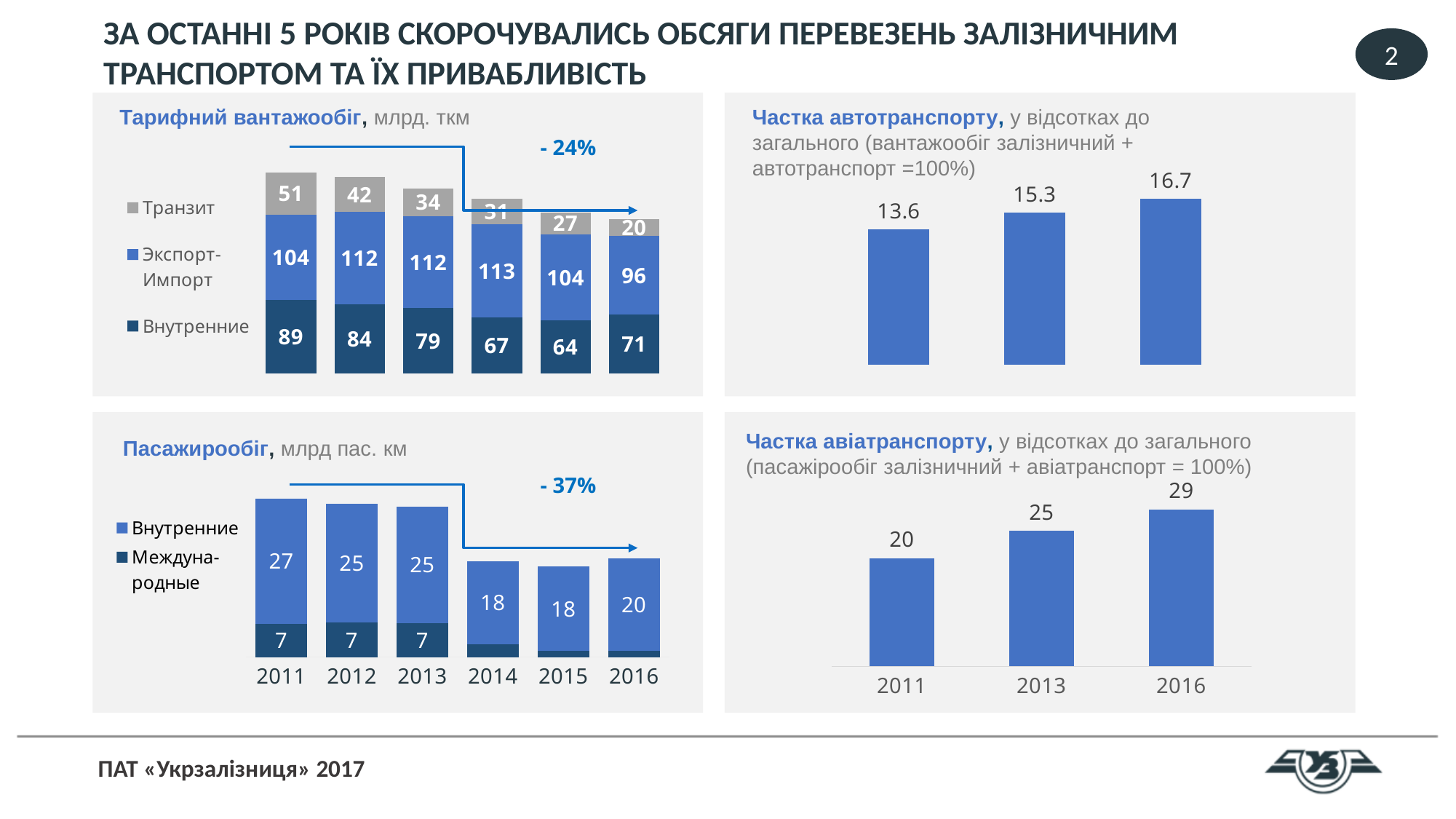
In the 'Тарифний вантажообіг' chart, what is the total of the last (rightmost) stacked bar? 187 In the 'Тарифний вантажообіг' chart, what is the Транзит value for the first (leftmost) bar? 51 In the 'Пасажирообіг' chart, how many years are shown on the x axis? 6 In the 'Частка авіатранспорту' chart, what is the value for 2016? 29 In the 'Частка авіатранспорту' chart, what is the difference between the 2016 and 2011 values? 9 In the 'Частка автотранспорту' chart, which bar is the highest? the third (rightmost) bar, 16.7 In the 'Пасажирообіг' chart, is the Внутренние value for 2012 larger or smaller than the value for 2015? larger In the 'Частка автотранспорту' chart, what is the value of the first (leftmost) bar? 13.6 In the 'Пасажирообіг' chart, what is the Внутренние value for 2011? 27 In the 'Тарифний вантажообіг' chart, how many series does the legend list? 3 In the 'Пасажирообіг' chart, what is the Международные value for 2013? 7 What type of chart is the 'Частка авіатранспорту' chart? bar chart